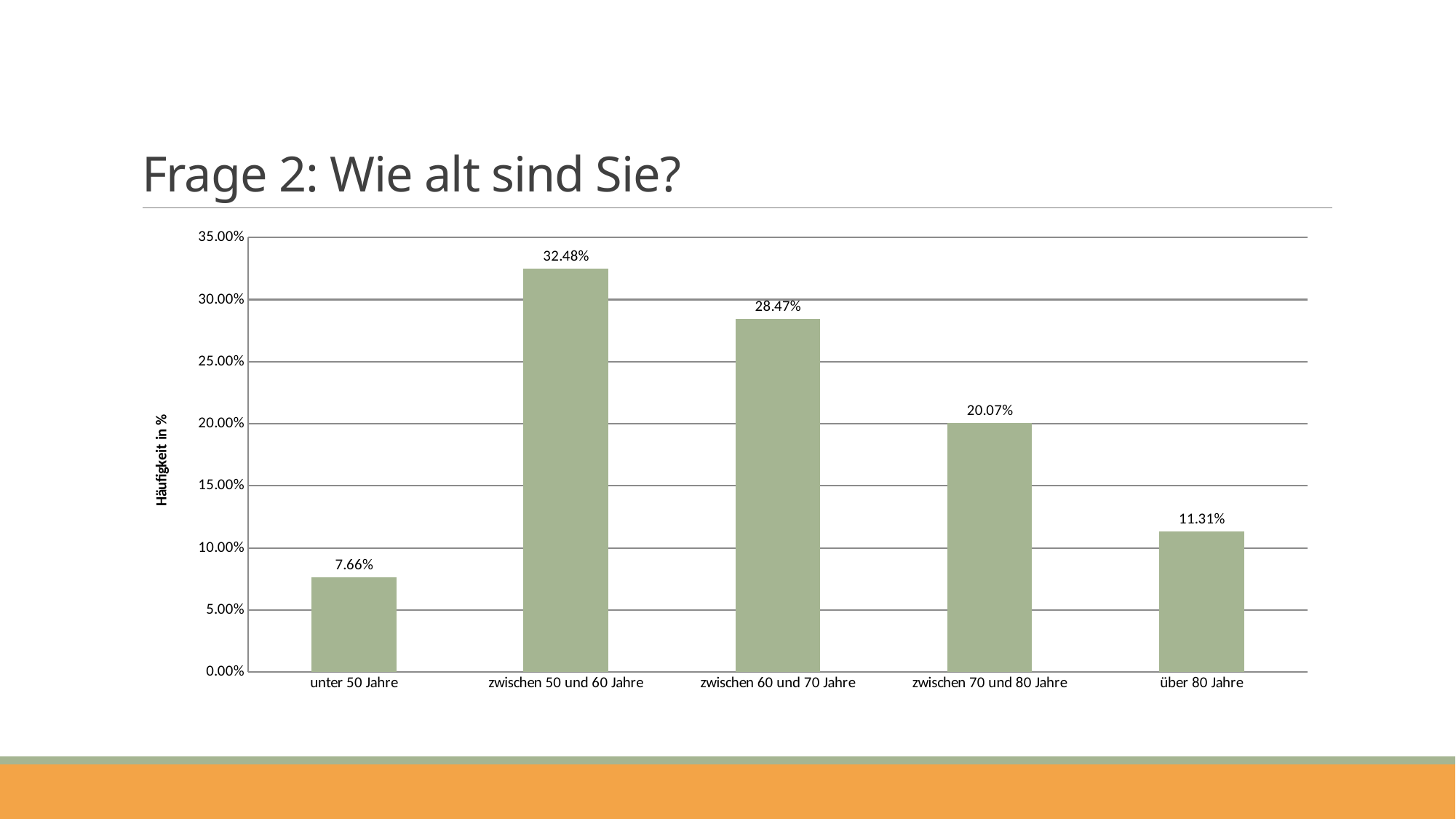
Which is larger: the value for "über 80 Jahre" or the value for "unter 50 Jahre"? über 80 Jahre What kind of chart is shown on the slide? bar chart Which age category has the highest value? zwischen 50 und 60 Jahre How many age categories are shown on the x axis? 5 Which age category has the lowest value? unter 50 Jahre Do the values rise or fall from "zwischen 50 und 60 Jahre" to "über 80 Jahre"? fall What is the value for "über 80 Jahre"? 11.31% What is the value for "zwischen 50 und 60 Jahre"? 32.48% What is the value for "unter 50 Jahre"? 7.66% What is the difference between the values for "zwischen 60 und 70 Jahre" and "zwischen 70 und 80 Jahre"? 8.40% What is the label of the vertical axis? Häufigkeit in % Is the value for "zwischen 60 und 70 Jahre" greater or less than 25.00%? greater